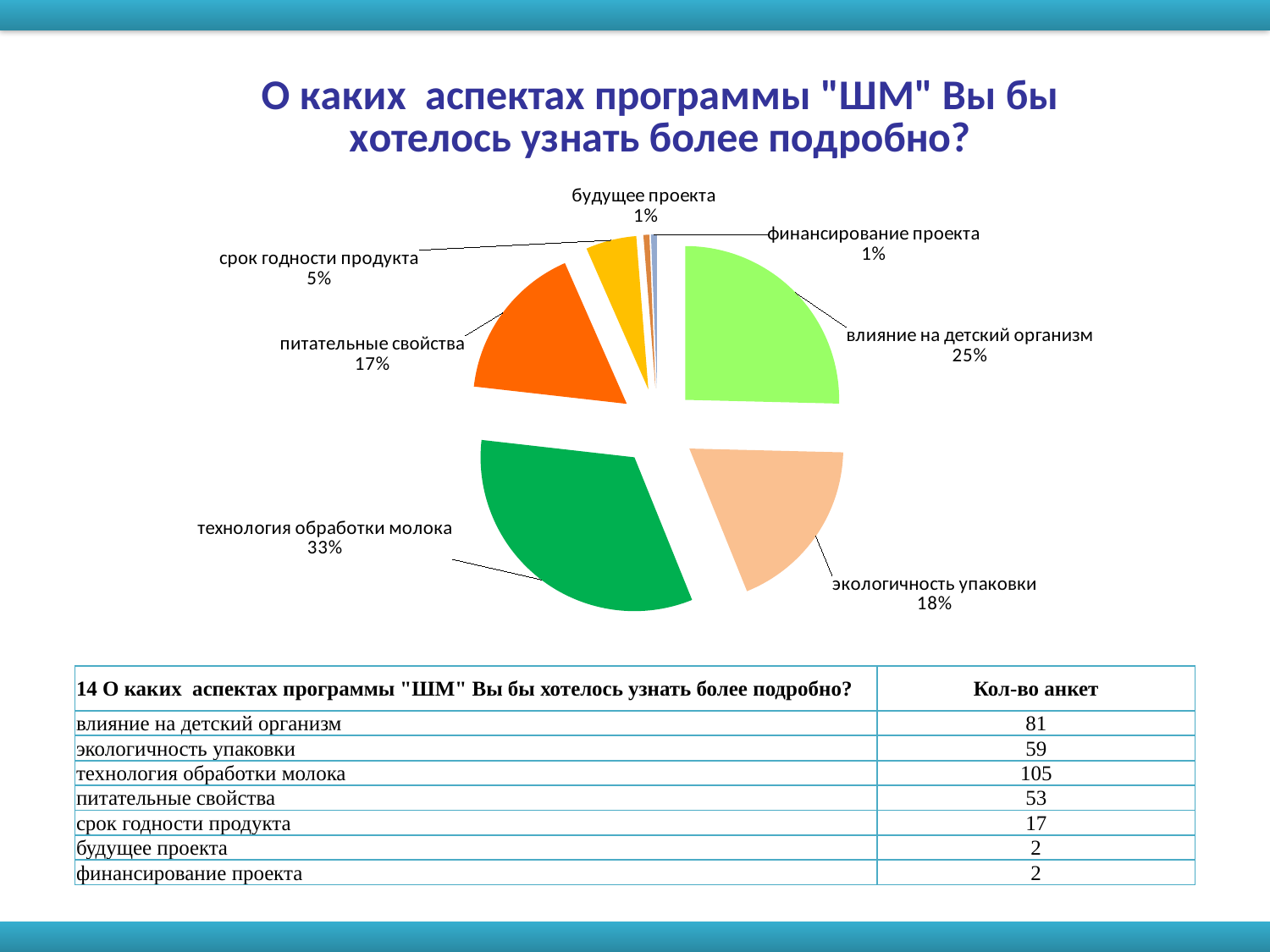
What kind of chart is shown on the slide? pie chart What percentage is shown for "будущее проекта"? 1% What percentage is shown for "экологичность упаковки"? 18% What is the difference in percentage points between "технология обработки молока" and "влияние на детский организм"? 8 How many slices does the pie chart have? 7 What percentage is shown for "питательные свойства"? 17% What share of the pie does "влияние на детский организм" have? 25% Which category has the largest slice of the pie? технология обработки молока What is the title of the slide above the pie chart? О каких аспектах программы "ШМ" Вы бы хотелось узнать более подробно? Which is larger: the slice for "влияние на детский организм" or the slice for "экологичность упаковки"? влияние на детский организм What percentage is shown for "срок годности продукта"? 5% What share of the pie does "технология обработки молока" have? 33%